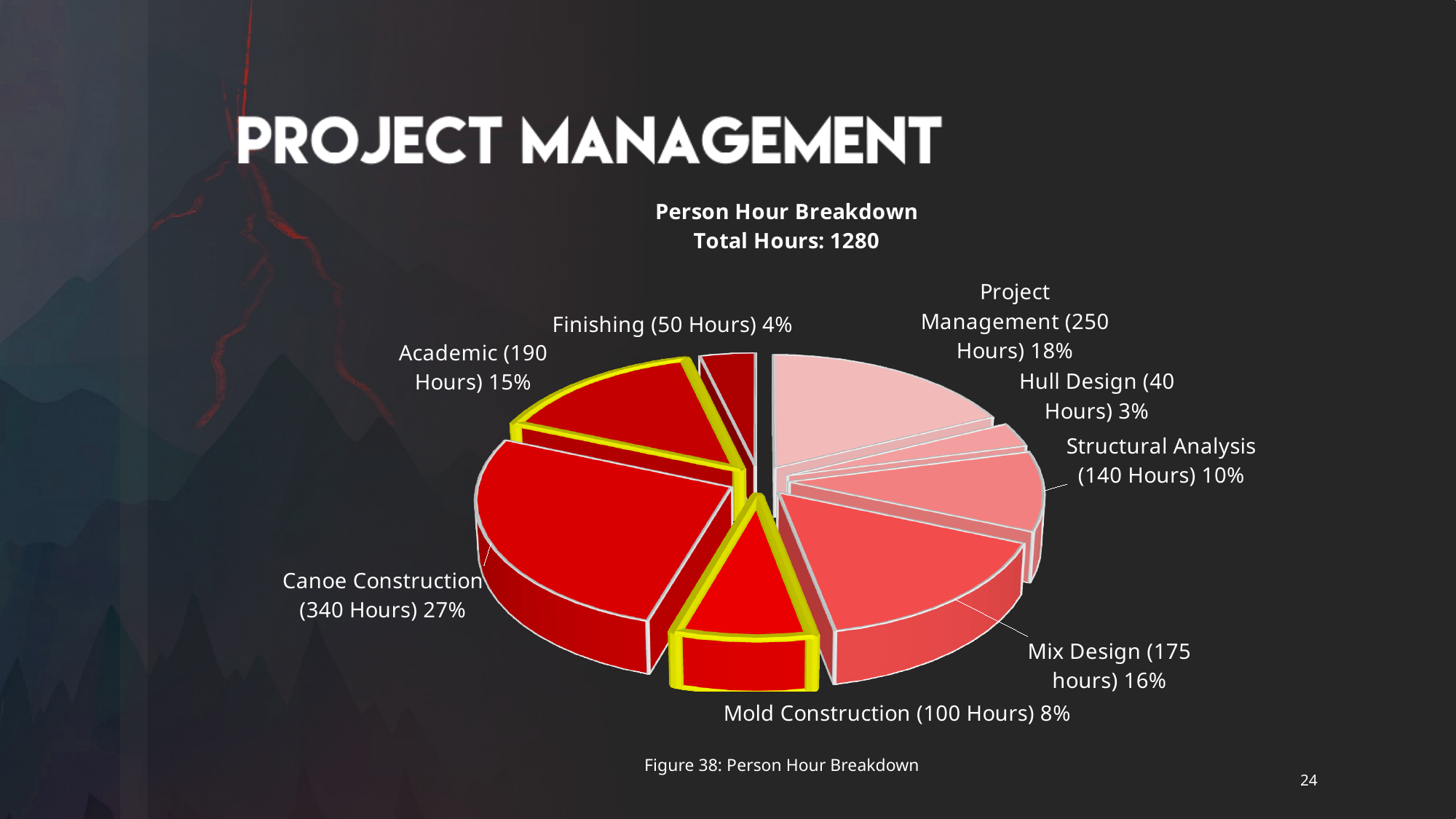
How many hours are shown for Structural Analysis? 140 Hours How many categories does the Person Hour Breakdown pie chart show? 8 What percentage of the total hours is Mold Construction? 8% What kind of chart is shown on the slide? Pie chart How many hours are shown for Canoe Construction? 340 Hours What percentage of the total hours is Project Management? 18% What total number of hours is stated in the chart title? 1280 Which has more hours, Mix Design or Academic? Mix Design What is the figure caption below the chart? Figure 38: Person Hour Breakdown What is the difference in hours between Canoe Construction and Academic? 150 Hours Which category has the smallest share of person hours? Hull Design Which category has the largest share of person hours? Canoe Construction